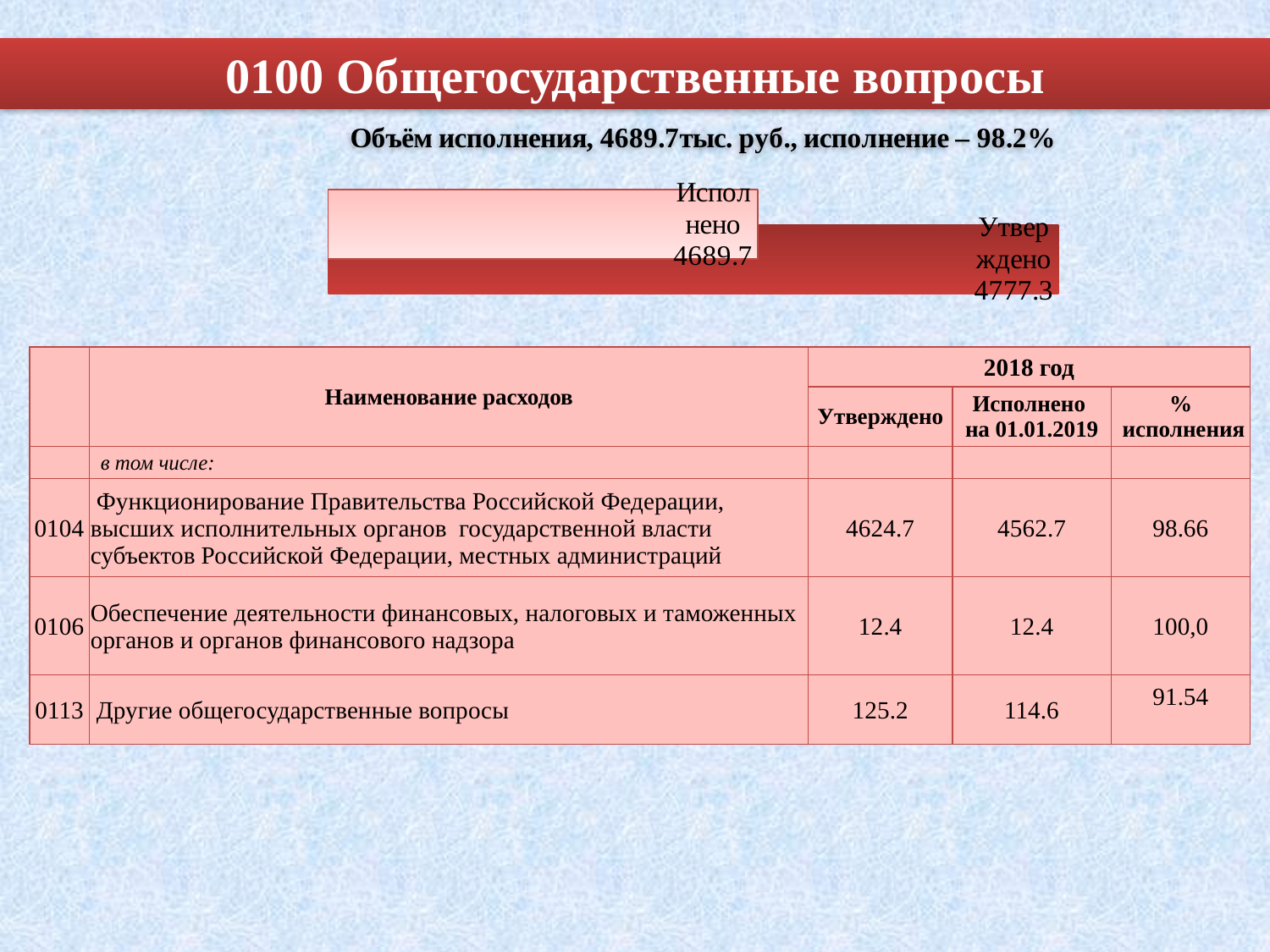
What is the difference between the Утверждено and Исполнено values in the chart? 87.6 Which bar in the chart has the higher value? Утверждено Is the Исполнено value larger or smaller than the Утверждено value in the chart? smaller What kind of chart is shown on the slide? bar chart Which bar in the chart is coloured dark red? Утверждено What is the title of the slide containing the chart? 0100 Общегосударственные вопросы How many bars are plotted in the chart? 2 Which bar in the chart has the lower value? Исполнено What is the value of the Утверждено bar in the chart? 4777.3 What is the value of the Исполнено bar in the chart? 4689.7